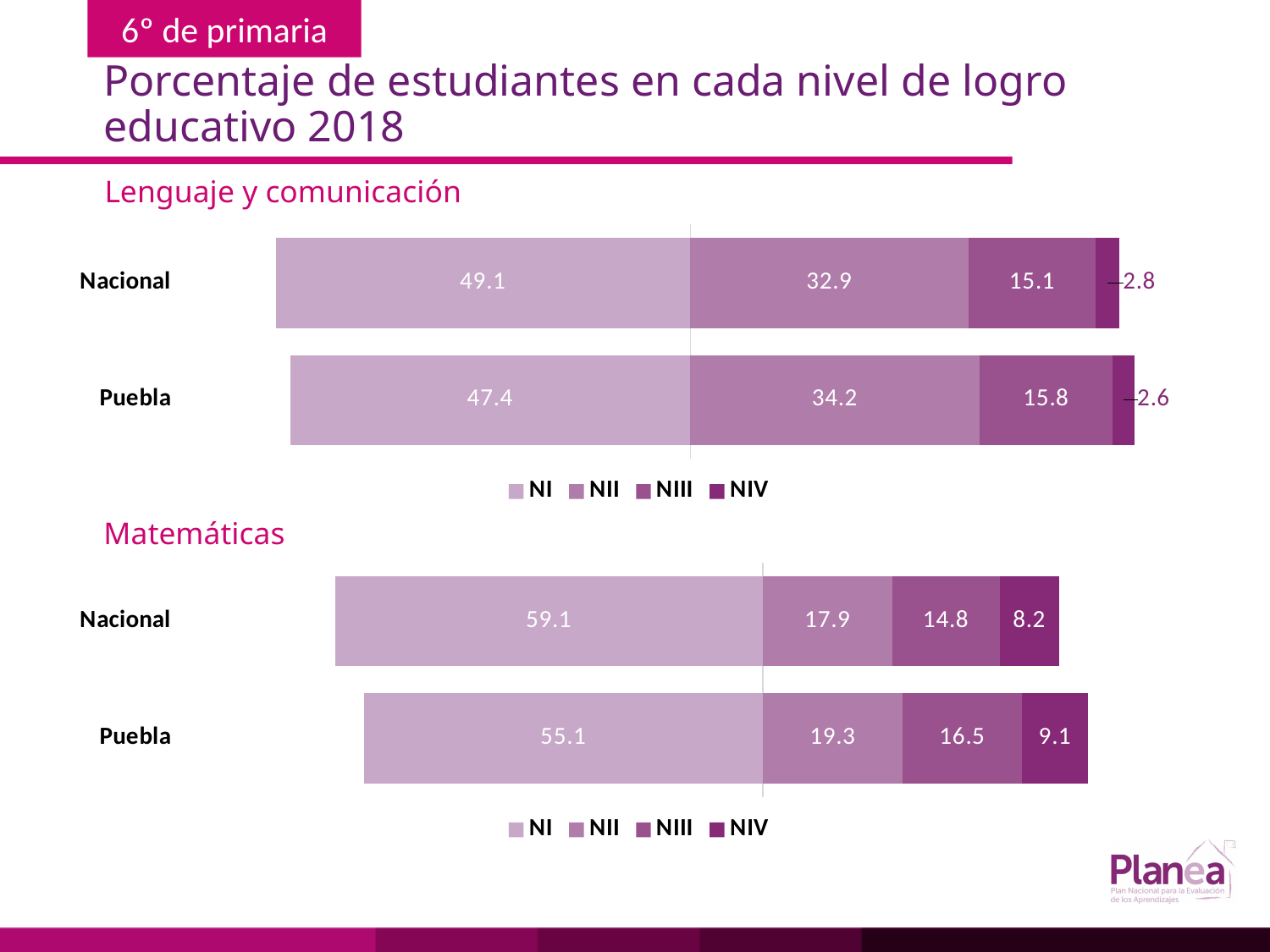
In the Matemáticas chart, what is the NIV value for Nacional? 8.2 In the Matemáticas chart, what is the difference between the NI values for Nacional and Puebla? 4.0 How many series does the legend of the Matemáticas chart list? 4 In the Lenguaje y comunicación chart, what is the NIV value for Puebla? 2.6 What kind of chart is the Lenguaje y comunicación chart? Stacked bar chart How many categories are shown in the Lenguaje y comunicación chart? 2 In the Matemáticas chart, what is the total of the stacked bar for Puebla? 100.0 In the Matemáticas chart, what is the NII value for Puebla? 19.3 In the Lenguaje y comunicación chart, which is larger, the NII value for Nacional or for Puebla? Puebla In the Lenguaje y comunicación chart, what is the NI value for Nacional? 49.1 In the Matemáticas chart, which level has the highest value for Nacional? NI In the Lenguaje y comunicación chart, which level has the lowest value for Puebla? NIV